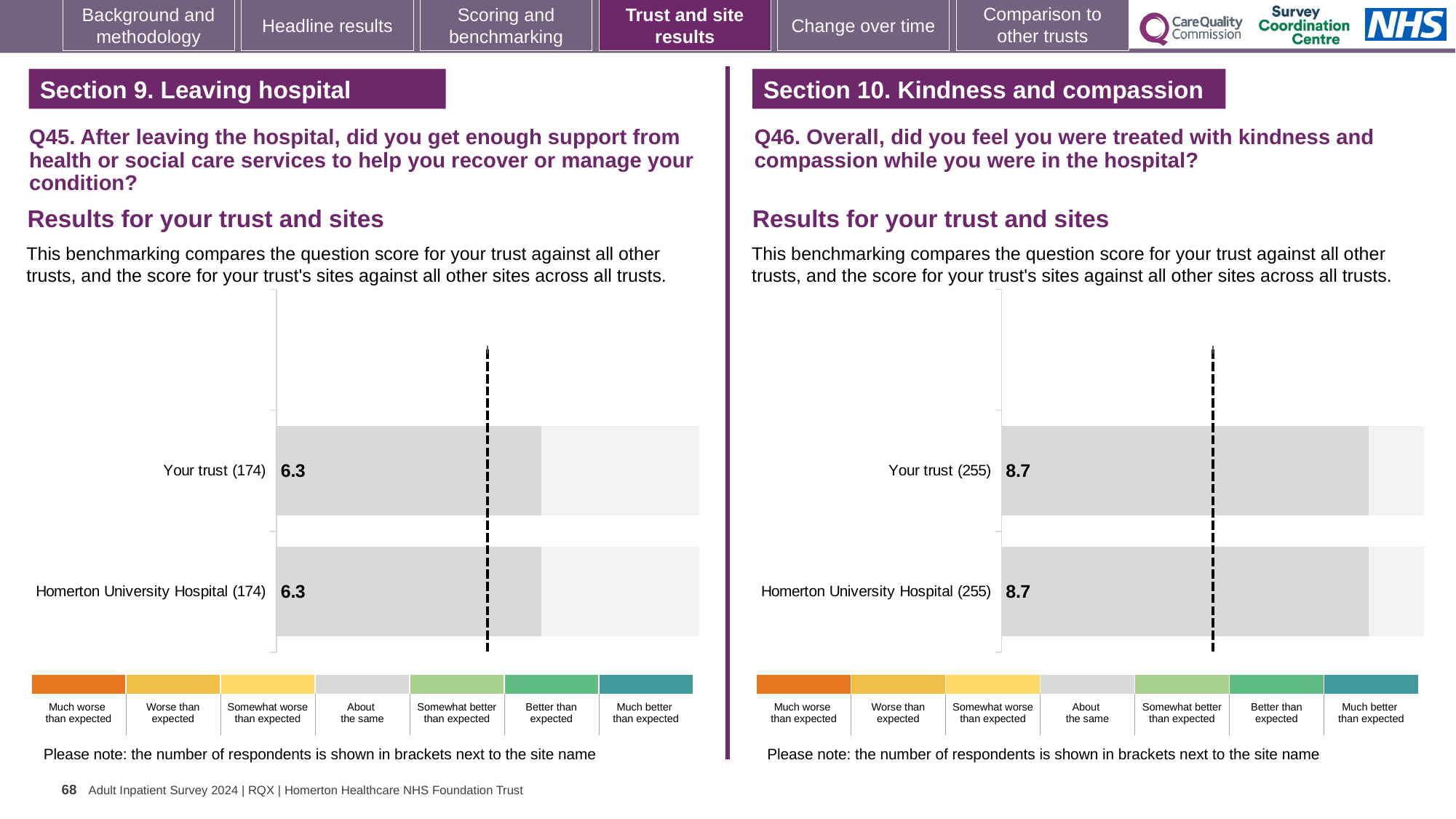
How many bars are plotted on the Q45 chart (left)? 2 On the Q45 chart (left), what is the score for Your trust? 6.3 On the Q46 chart (right), how many respondents are shown in brackets next to Homerton University Hospital? 255 On the Q46 chart (right), what is the score for Homerton University Hospital? 8.7 On the Q45 chart (left), what is the score for Homerton University Hospital? 6.3 On the Q46 chart (right), what is the score for Your trust? 8.7 How many bars are plotted on the Q46 chart (right)? 2 Is the score for Your trust on the Q46 chart (right) larger or smaller than the score for Your trust on the Q45 chart (left)? Larger What kind of chart is used for the Q45 results on the left? Bar chart On the Q46 chart (right), what is the difference between the score for Your trust and the score for Homerton University Hospital? 0.0 On the Q45 chart (left), what is the difference between the score for Your trust and the score for Homerton University Hospital? 0.0 On the Q45 chart (left), how many respondents are shown in brackets next to Your trust? 174